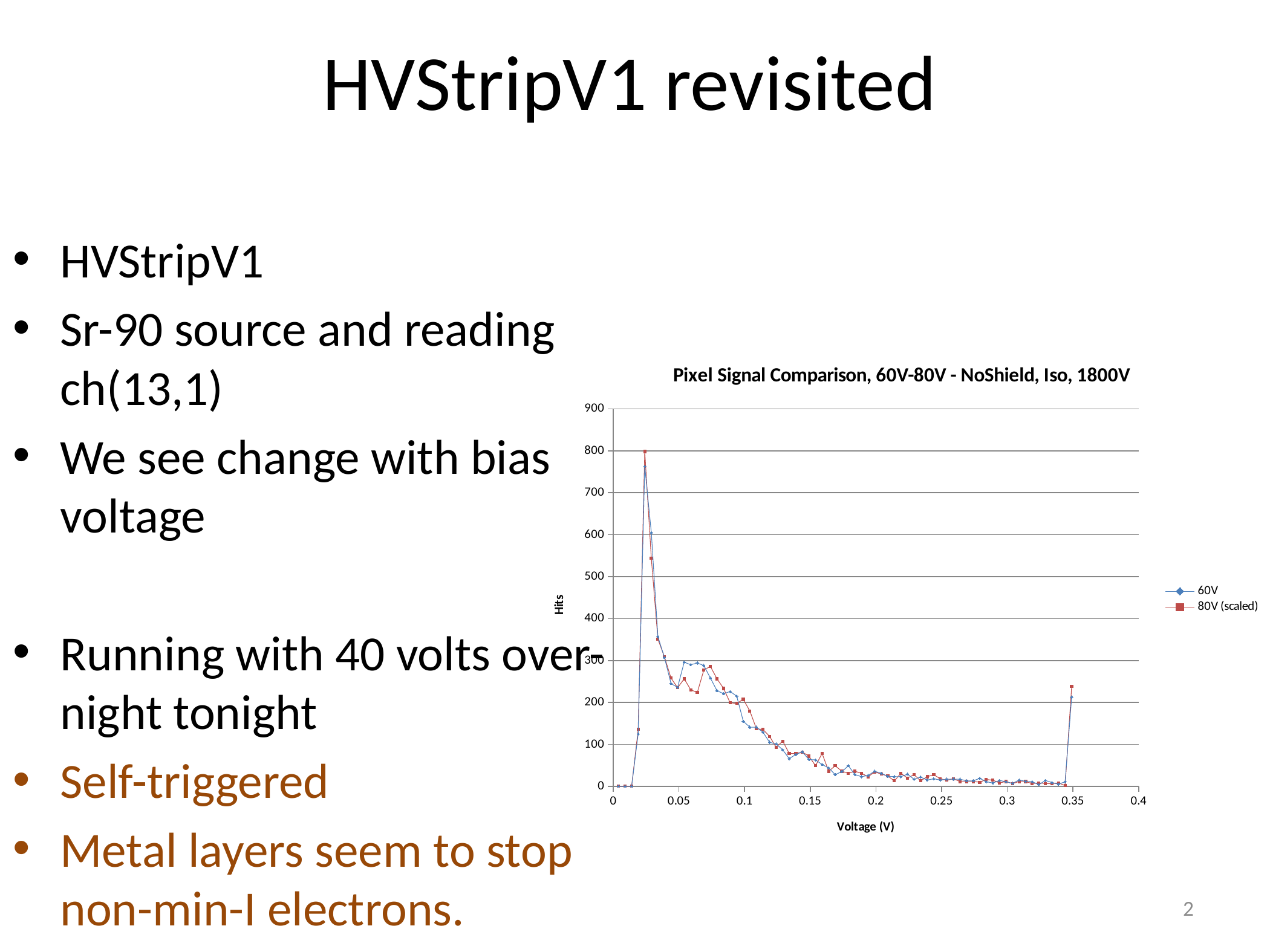
Is the value of the 60V series at 0.3 V greater or less than 100? less Is the value of the 80V (scaled) series at 0.2 V greater or less than 100? less What is the label of the chart's x axis? Voltage (V) What kind of chart is shown on the slide? line chart Between 0.05 V and 0.3 V, do the hits for the 60V series generally rise or fall as voltage increases? fall Which series reaches the higher peak value, 60V or 80V (scaled)? 80V (scaled) Is the peak value of the 80V (scaled) series greater or less than 600? greater How many series does the chart's legend list? 2 What is the title of the chart? Pixel Signal Comparison, 60V-80V - NoShield, Iso, 1800V